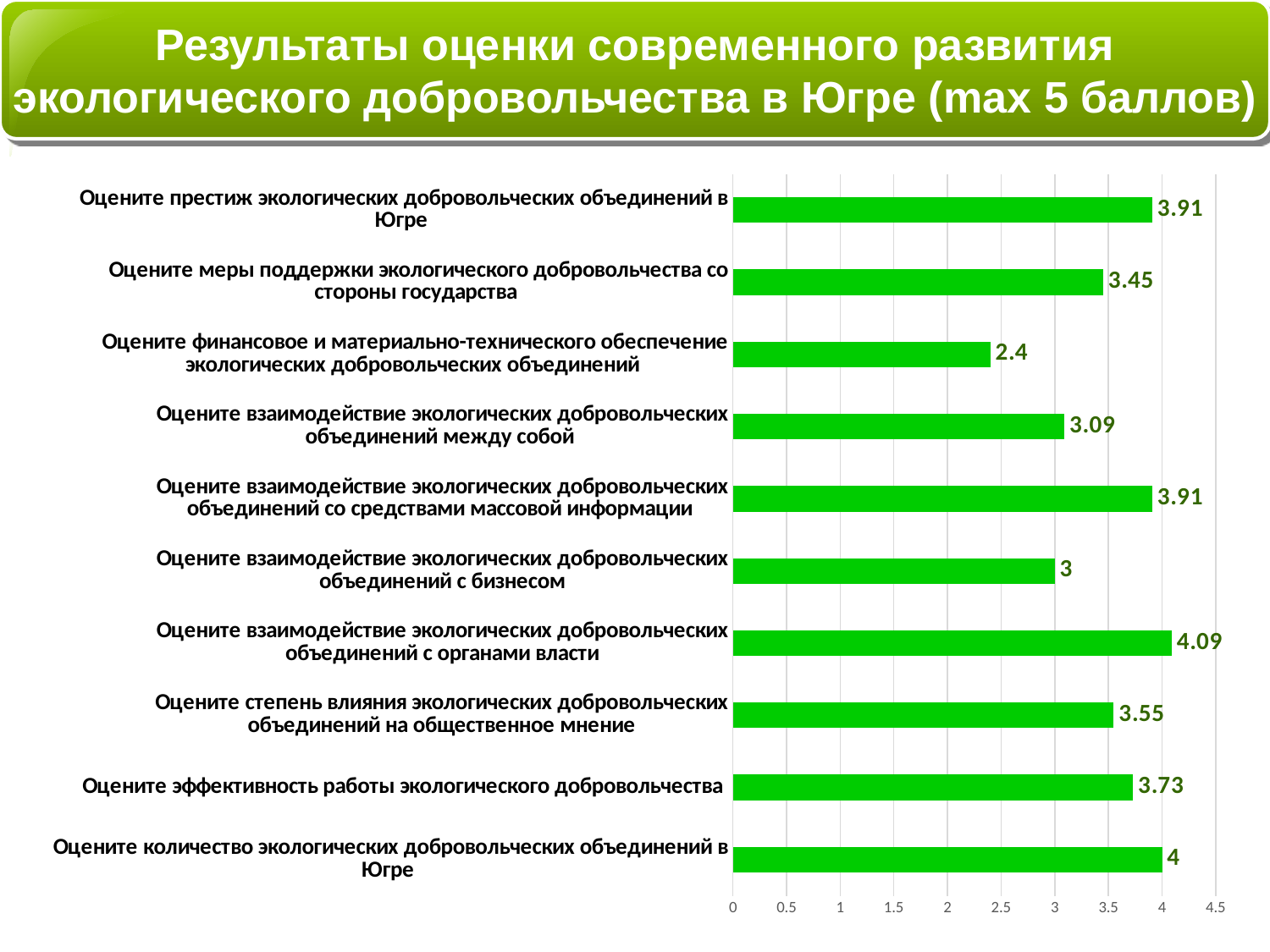
How many categories are shown in the chart? 10 What is the value for «Оцените взаимодействие экологических добровольческих объединений с органами власти»? 4.09 Which is larger: the value for «Оцените степень влияния экологических добровольческих объединений на общественное мнение» or for «Оцените взаимодействие экологических добровольческих объединений между собой»? Оцените степень влияния экологических добровольческих объединений на общественное мнение Which category has the lowest value? Оцените финансовое и материально-технического обеспечение экологических добровольческих объединений Which category has the highest value? Оцените взаимодействие экологических добровольческих объединений с органами власти What is the value for «Оцените эффективность работы экологического добровольчества»? 3.73 What is the difference between the highest value (4.09) and the lowest value (2.4)? 1.69 What is the value for «Оцените финансовое и материально-технического обеспечение экологических добровольческих объединений»? 2.4 Is the value for «Оцените меры поддержки экологического добровольчества со стороны государства» greater or less than 3? greater What is the value for «Оцените взаимодействие экологических добровольческих объединений с бизнесом»? 3 What is the difference between «Оцените количество экологических добровольческих объединений в Югре» and «Оцените эффективность работы экологического добровольчества»? 0.27 What kind of chart is shown on the slide? bar chart